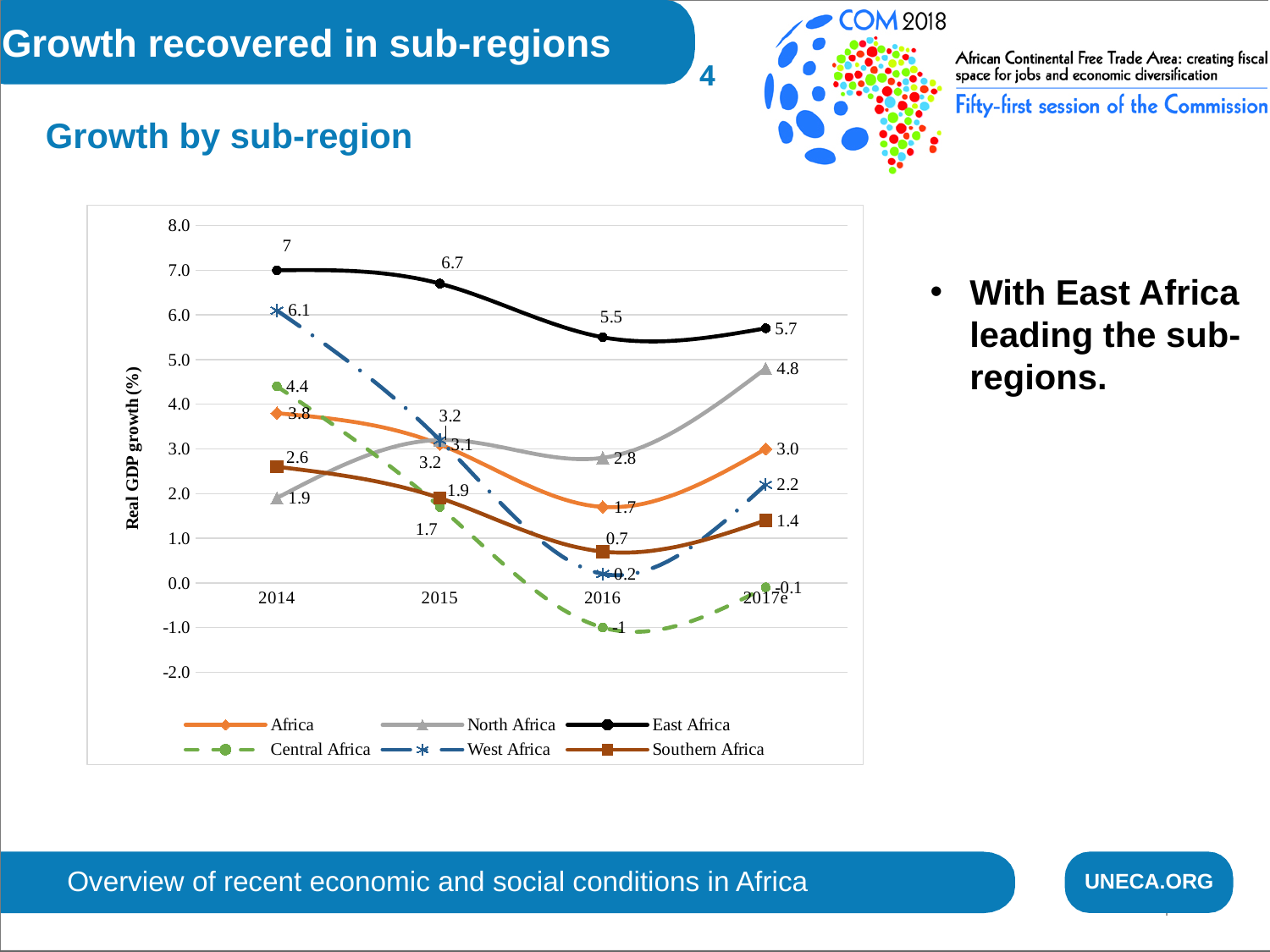
What is the value for North Africa in 2017e? 4.8 How many series does the legend list? 6 What is the value for West Africa in 2014? 6.1 What is the value for Southern Africa in 2016? 0.7 Does the East Africa line rise or fall from 2014 to 2016? Fall Which series has the lowest value in 2016? Central Africa Which sub-region has the highest value in 2017e? East Africa What is the value for East Africa in 2014? 7 What kind of chart is shown? Line chart In 2014, which is larger: the value for West Africa or the value for Central Africa? West Africa What is the value for Central Africa in 2016? -1 What is the difference between the East Africa values for 2014 and 2017e? 1.3